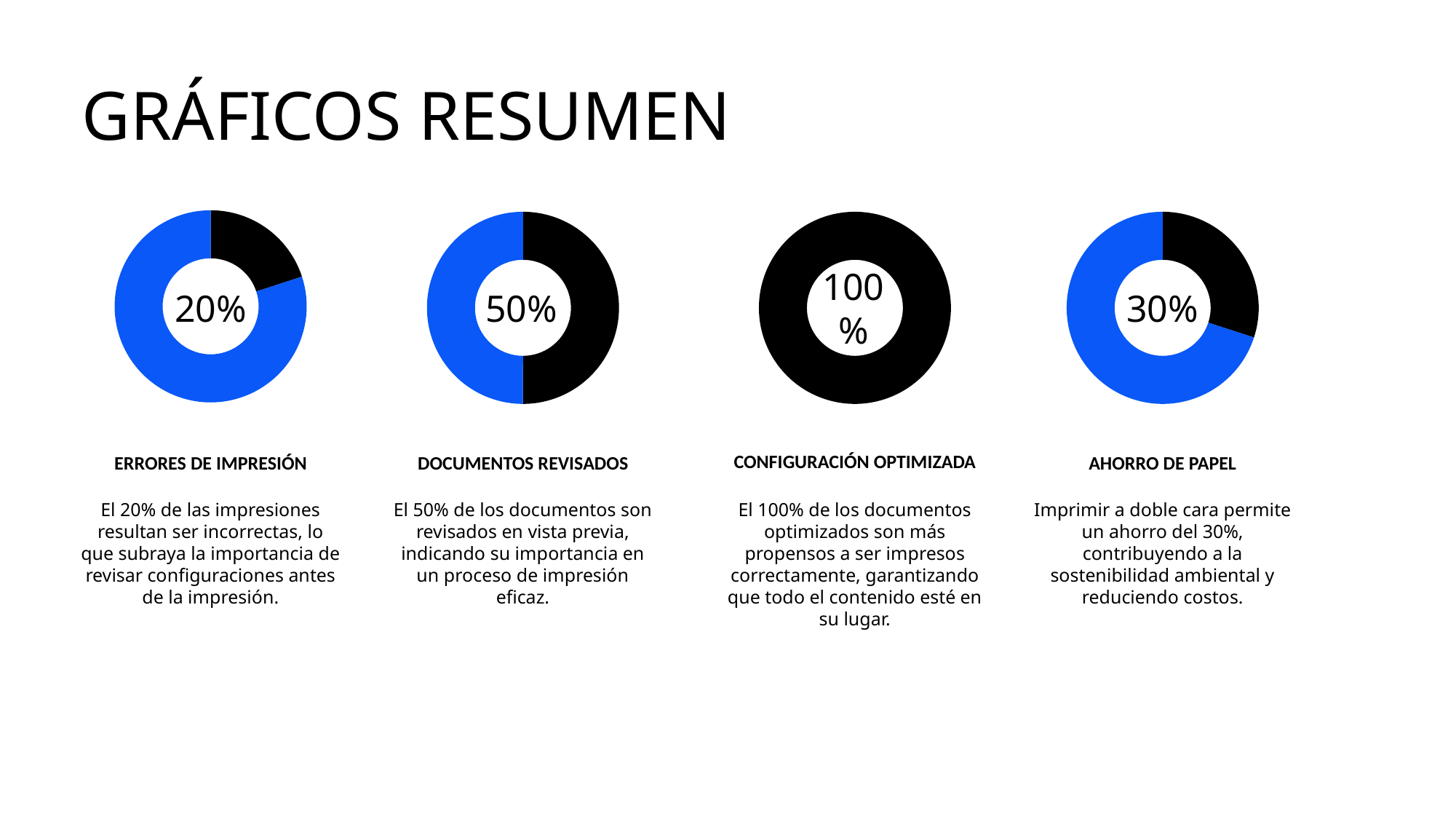
What percentage is shown in the centre of the AHORRO DE PAPEL donut chart? 30% How many donut charts are shown on the slide? 4 Which is larger, the percentage for DOCUMENTOS REVISADOS or the percentage for AHORRO DE PAPEL? DOCUMENTOS REVISADOS What percentage is shown in the centre of the ERRORES DE IMPRESIÓN donut chart? 20% What percentage is shown in the centre of the DOCUMENTOS REVISADOS donut chart? 50% What kind of chart is used for each of the four metrics on the slide? Donut chart What is the difference between the CONFIGURACIÓN OPTIMIZADA percentage and the AHORRO DE PAPEL percentage? 70% In the CONFIGURACIÓN OPTIMIZADA donut chart, what colour is the entire ring? Black Which of the four donut charts shows the lowest percentage? ERRORES DE IMPRESIÓN What percentage is shown in the centre of the CONFIGURACIÓN OPTIMIZADA donut chart? 100% What is the difference between the DOCUMENTOS REVISADOS percentage and the ERRORES DE IMPRESIÓN percentage? 30% Which of the four donut charts shows the highest percentage? CONFIGURACIÓN OPTIMIZADA